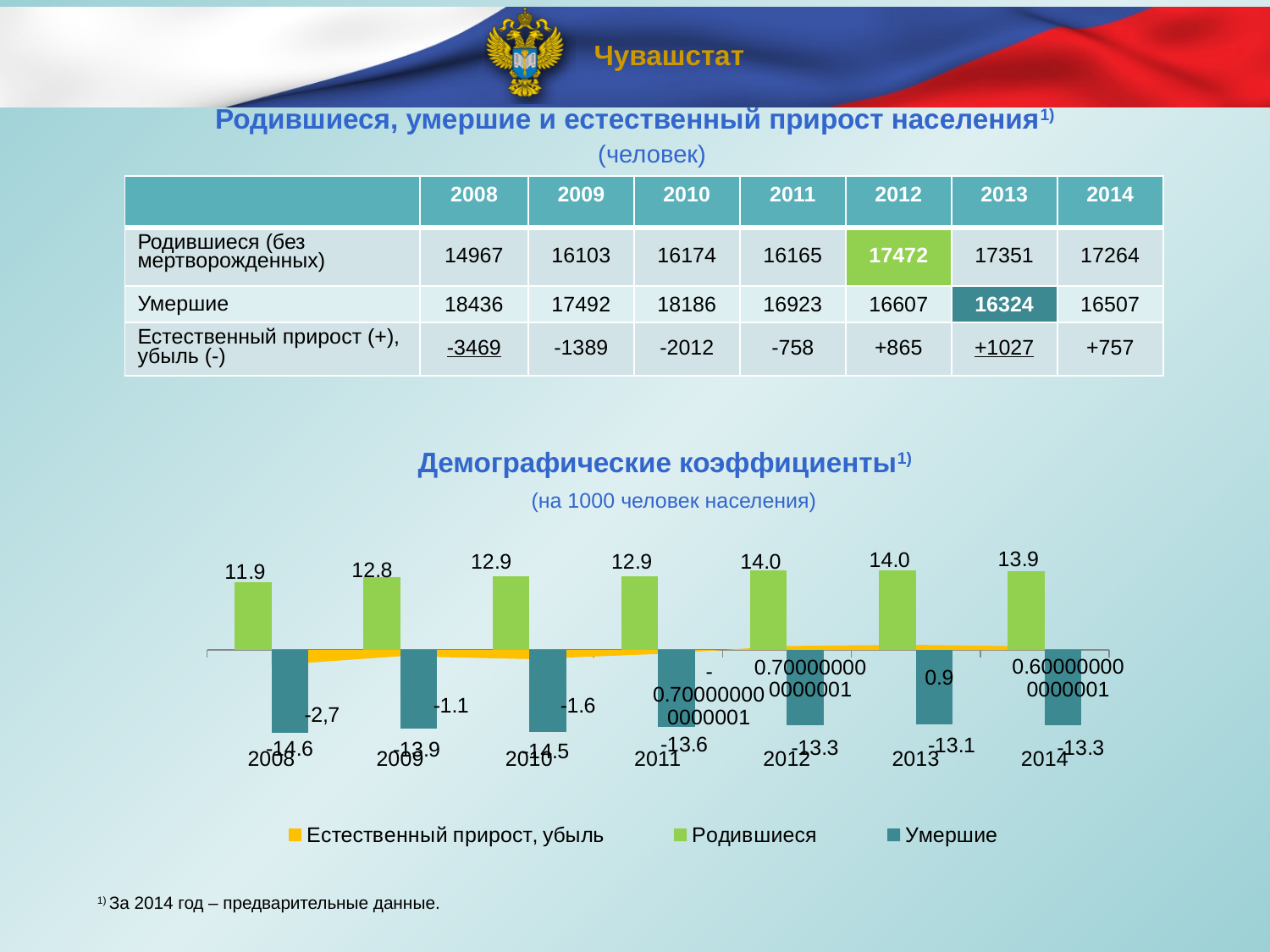
In the chart 'Демографические коэффициенты', which year has the lowest value for Родившиеся? 2008 How many years are shown on the x axis of the chart 'Демографические коэффициенты'? 7 How many series does the legend of the chart 'Демографические коэффициенты' list? 3 In the chart 'Демографические коэффициенты', do the Родившиеся values rise or fall from 2008 to 2012? rise In the chart 'Демографические коэффициенты', which is larger, the Родившиеся value for 2009 or for 2012? 2012 In the chart 'Демографические коэффициенты', what is the value for Умершие in 2013? -13.1 In the chart 'Демографические коэффициенты', what is the difference between the Родившиеся values for 2014 and 2008? 2.0 In the chart 'Демографические коэффициенты', what is the value for Родившиеся in 2014? 13.9 What kind of chart is 'Демографические коэффициенты'? combination bar and area chart In the chart 'Демографические коэффициенты', in which year is the Умершие value most negative? 2008 In the chart 'Демографические коэффициенты', what is the value for Родившиеся in 2008? 11.9 In the chart 'Демографические коэффициенты', what is the value for Естественный прирост, убыль in 2013? 0.9